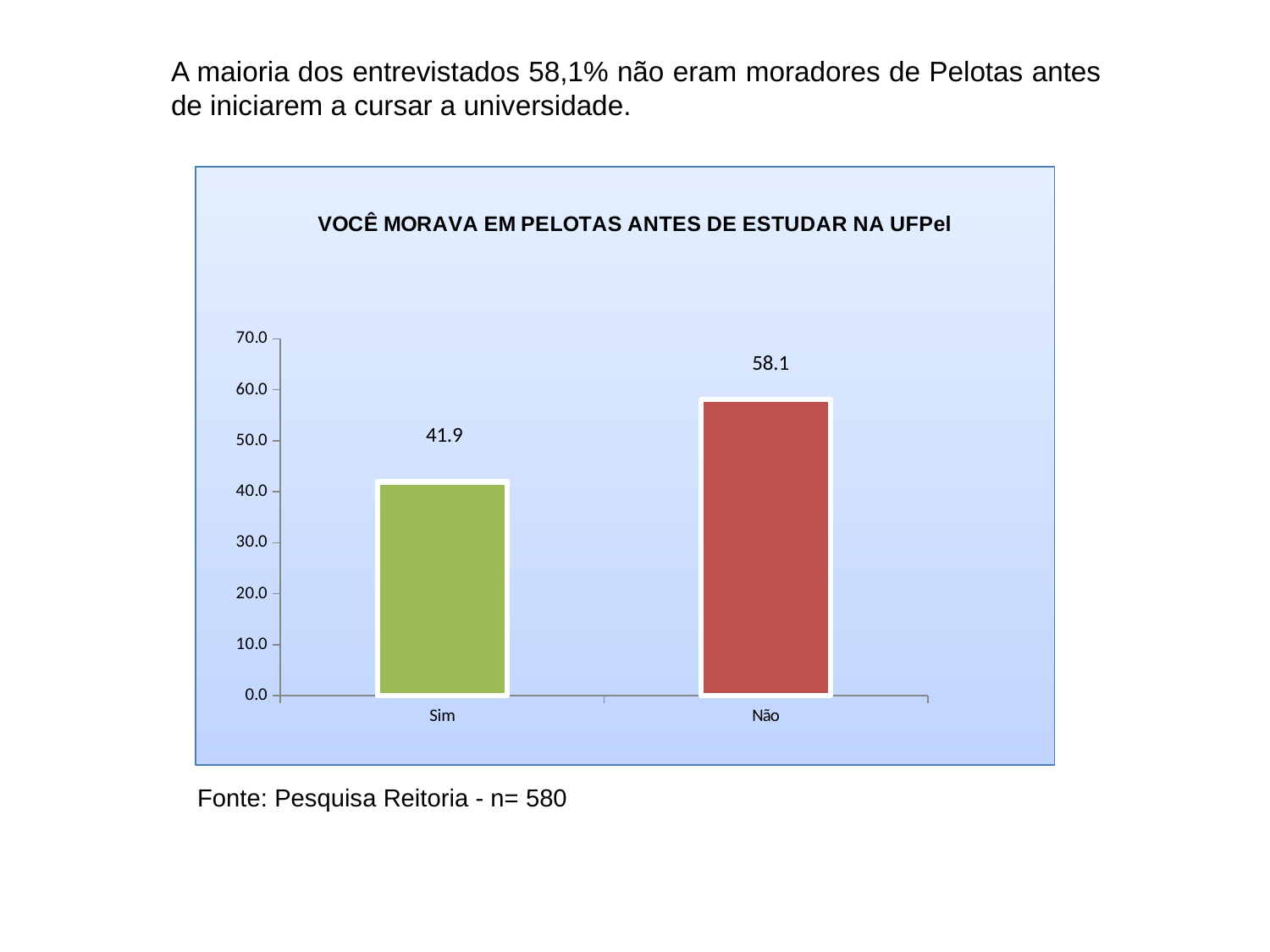
What is the title of the chart? VOCÊ MORAVA EM PELOTAS ANTES DE ESTUDAR NA UFPel What kind of chart is shown on the slide? bar chart What is the difference between the values for Não and Sim? 16.2 Which category has the highest value? Não Which is larger, the value for Sim or the value for Não? Não How many categories are shown on the x axis? 2 Is the value for Não greater or less than 50.0? greater What colour is the bar for Não? red What is the value for Não? 58.1 What is the value for Sim? 41.9 Is the value for Sim greater or less than 50.0? less Which category has the lowest value? Sim